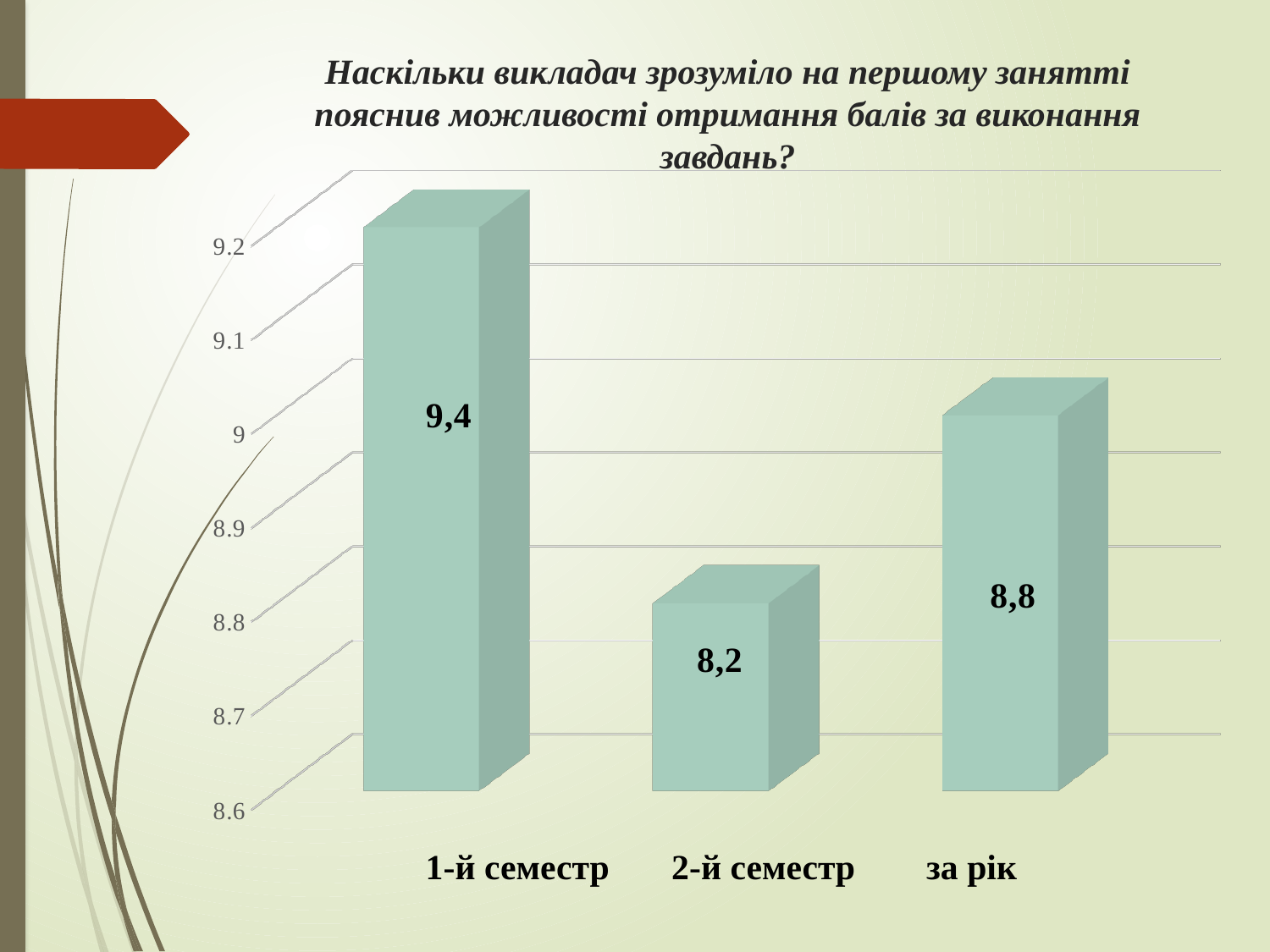
What is the title of the chart? Наскільки викладач зрозуміло на першому занятті пояснив можливості отримання балів за виконання завдань? What is the value for 2-й семестр? 8,2 What is the value for за рік? 8,8 What is the value for 1-й семестр? 9,4 Which category has the highest value? 1-й семестр What kind of chart is shown on the slide? bar chart Which is larger, the value for 1-й семестр or the value for за рік? 1-й семестр Is the value for 1-й семестр greater or less than 9? greater Which category has the lowest value? 2-й семестр What is the difference between the values for 1-й семестр and 2-й семестр? 1,2 How many categories are shown on the chart? 3 What is the difference between the values for за рік and 2-й семестр? 0,6